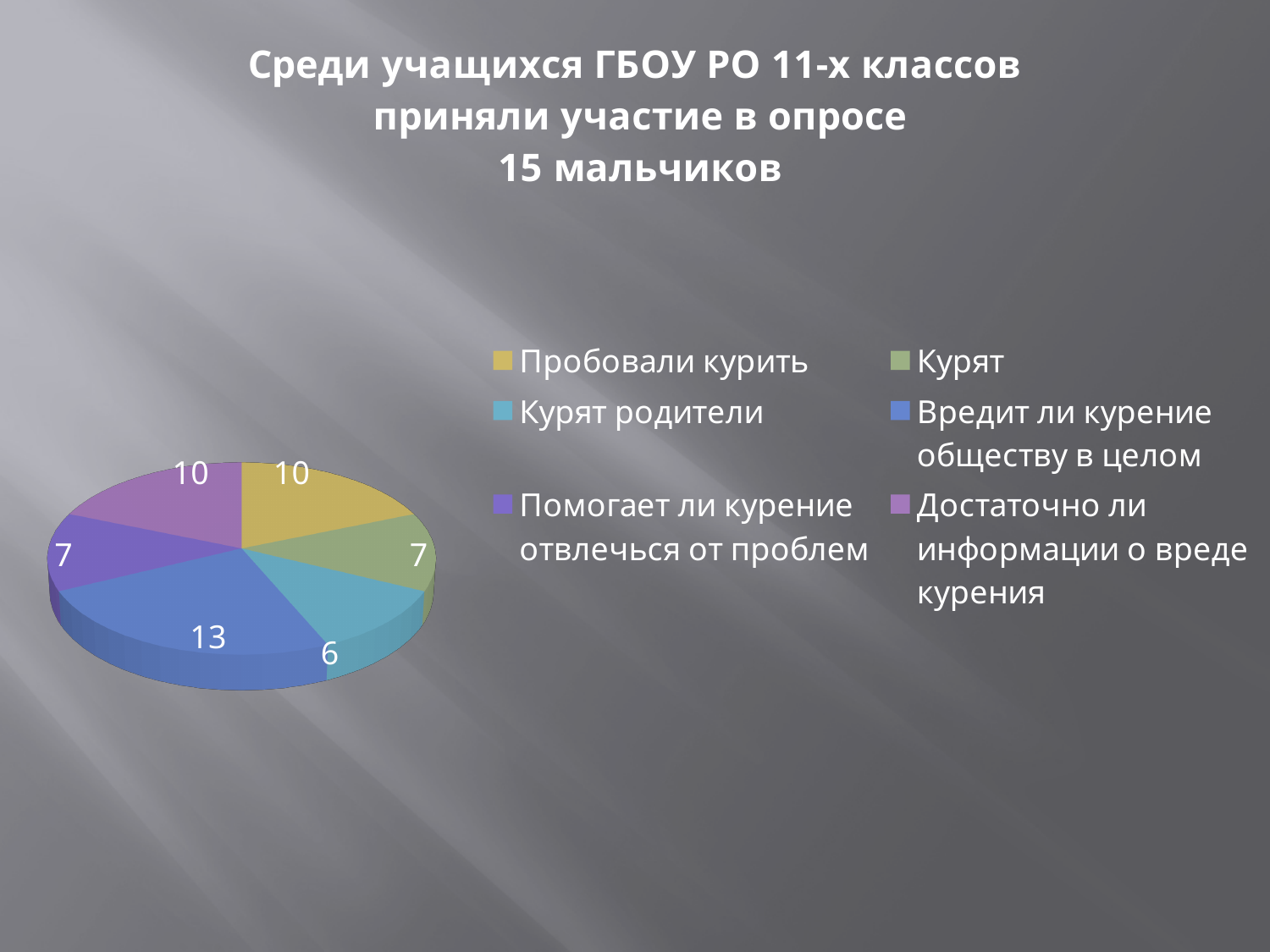
Which category has the smallest slice of the pie? Курят родители What is the value for "Курят"? 7 What kind of chart is shown on the slide? pie chart What is the value for "Курят родители"? 6 What is the difference between the values for "Вредит ли курение обществу в целом" and "Курят родители"? 7 Which category has the largest slice of the pie? Вредит ли курение обществу в целом How many slices does the pie chart have? 6 Which is larger: the value for "Пробовали курить" or the value for "Курят"? Пробовали курить What is the value for "Вредит ли курение обществу в целом"? 13 What is the value for "Пробовали курить"? 10 What is the difference between the values for "Достаточно ли информации о вреде курения" and "Помогает ли курение отвлечься от проблем"? 3 How many boys took part in the survey according to the slide title? 15